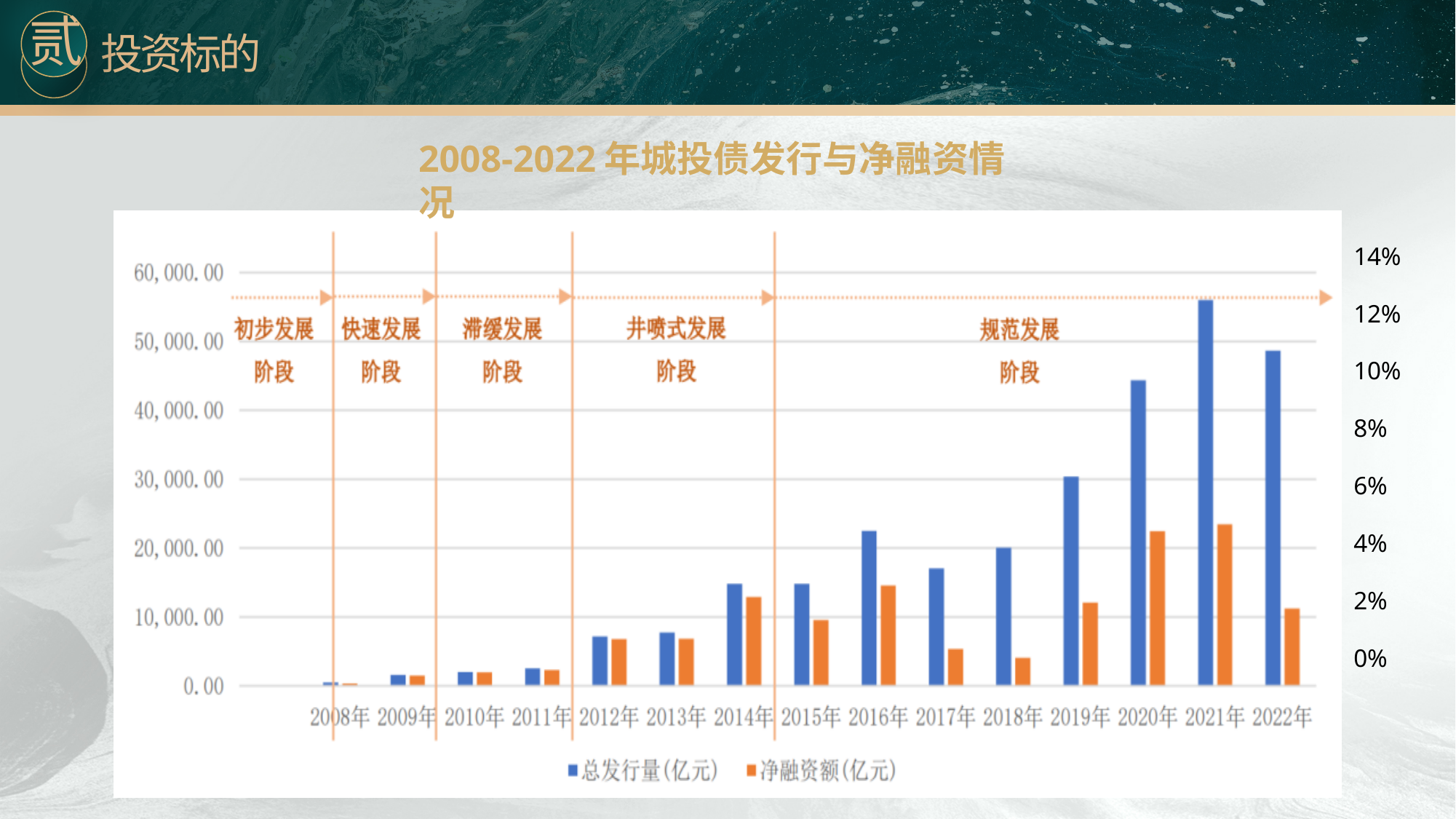
Does the 总发行量(亿元) rise or fall from 2019年 to 2021年? Rise How many series does the legend list? 2 Is the 净融资额(亿元) value for 2021年 greater or less than 20,000.00? greater What is the title of the chart? 2008-2022 年城投债发行与净融资情况 How many years are shown on the x axis of the chart? 15 Is the 总发行量(亿元) value for 2017年 greater or less than 20,000.00? less What kind of chart is shown on the slide? Bar chart Is the 净融资额(亿元) value for 2018年 greater or less than 10,000.00? less Which is larger, the 总发行量(亿元) for 2021年 or for 2022年? 2021年 Which year has the highest 总发行量(亿元) bar? 2021年 Which year has the lowest 总发行量(亿元) bar? 2008年